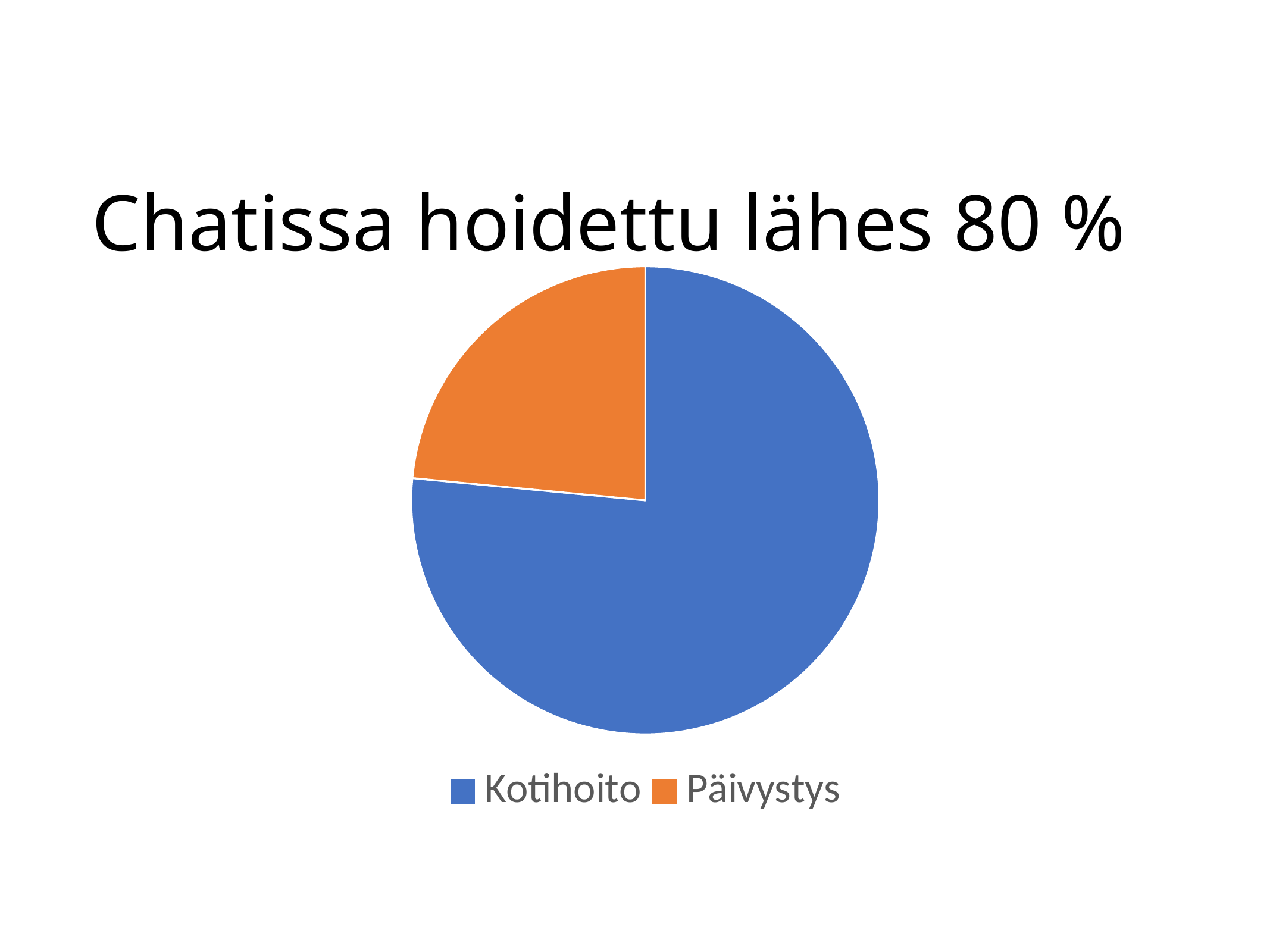
What is the title of the chart? Chatissa hoidettu lähes 80 % Which category has the smallest slice of the pie? Päivystys What colour is the Päivystys slice? Orange How many slices does the pie chart have? 2 How many entries does the legend list? 2 Which slice is larger, Kotihoito or Päivystys? Kotihoito What kind of chart is shown on the slide? Pie chart Which category has the largest slice of the pie? Kotihoito